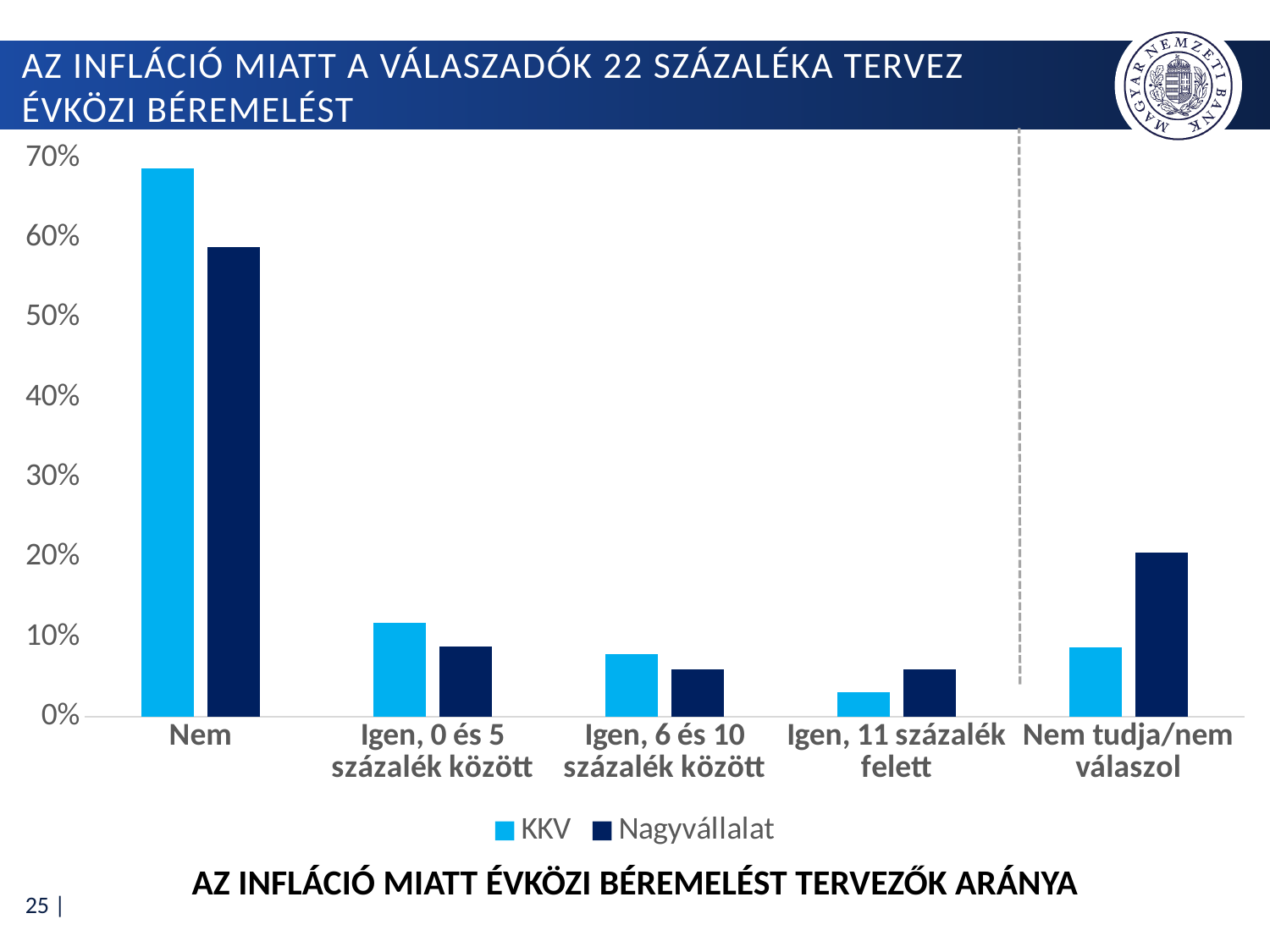
For 'Nem tudja/nem válaszol', which series has the larger value, KKV or Nagyvállalat? Nagyvállalat Which category has the highest value for the Nagyvállalat series? Nem Is the Nagyvállalat value for 'Nem' greater or less than 60%? less What kind of chart is shown on the slide? bar chart Is the Nagyvállalat value for 'Nem tudja/nem válaszol' greater or less than 10%? greater Which category has the highest value for the KKV series? Nem What are the two series named in the legend? KKV and Nagyvállalat How many categories are shown on the x axis of the chart? 5 Which category has the lowest value for the KKV series? Igen, 11 százalék felett How many series does the legend list? 2 For 'Igen, 0 és 5 százalék között', which series has the larger value, KKV or Nagyvállalat? KKV Is the KKV value for 'Nem' greater or less than 60%? greater